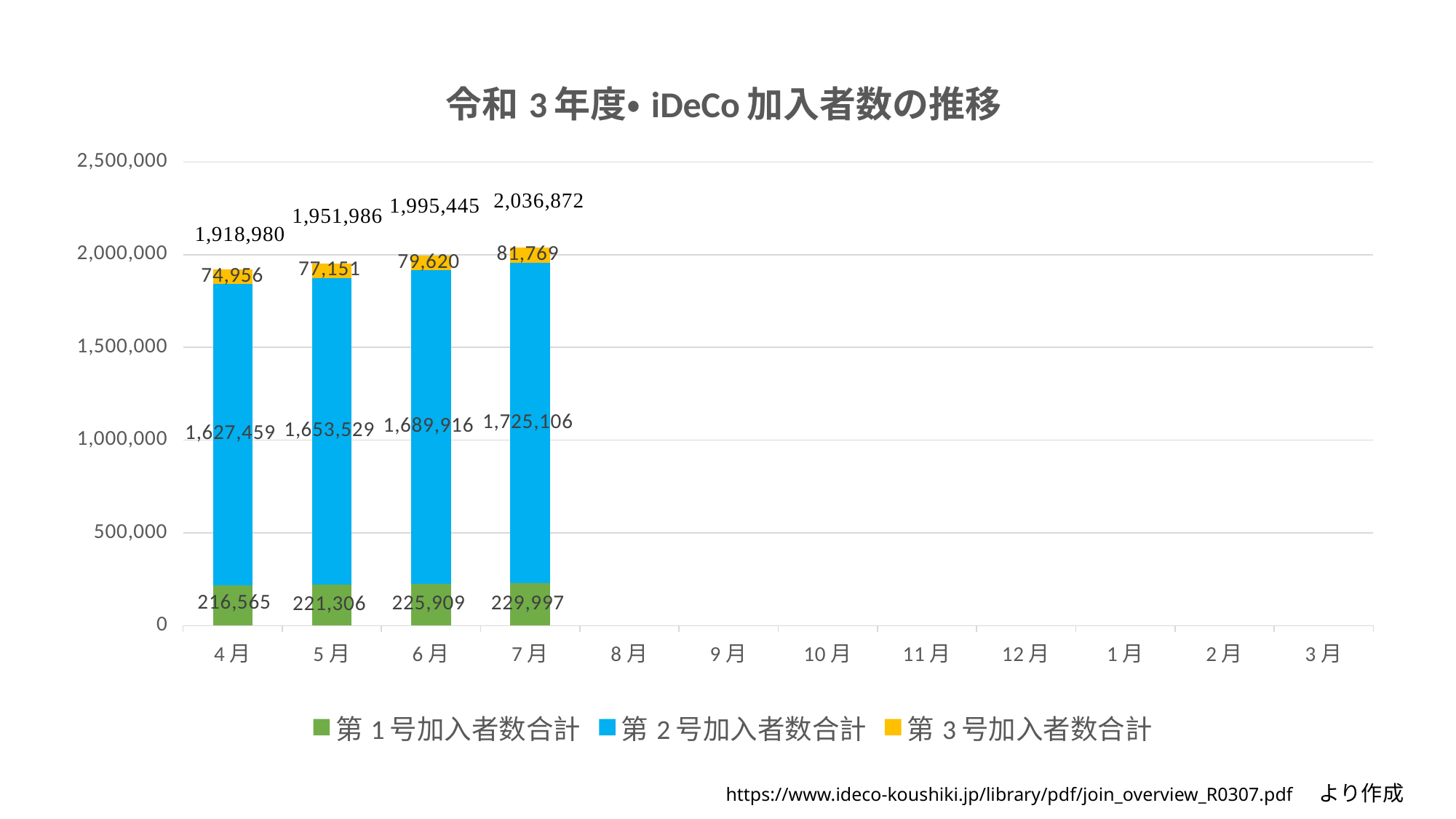
Do the stacked totals rise or fall from 4月 to 7月? Rise Which month has the highest stacked total? 7月 What is the total of the stacked bar for 5月? 1,951,986 Which month has the lowest value for 第１号加入者数合計? 4月 What is the value of 第２号加入者数合計 for 4月? 1,627,459 What is the difference between the 第２号加入者数合計 values for 7月 and 4月? 97,647 How many months have bars plotted on the chart? 4 How many series does the legend list? 3 What is the value of 第３号加入者数合計 for 7月? 81,769 Which is larger, the 第３号加入者数合計 value for 5月 or for 6月? 6月 What is the value of 第１号加入者数合計 for 6月? 225,909 What kind of chart is shown on the slide? Stacked bar chart